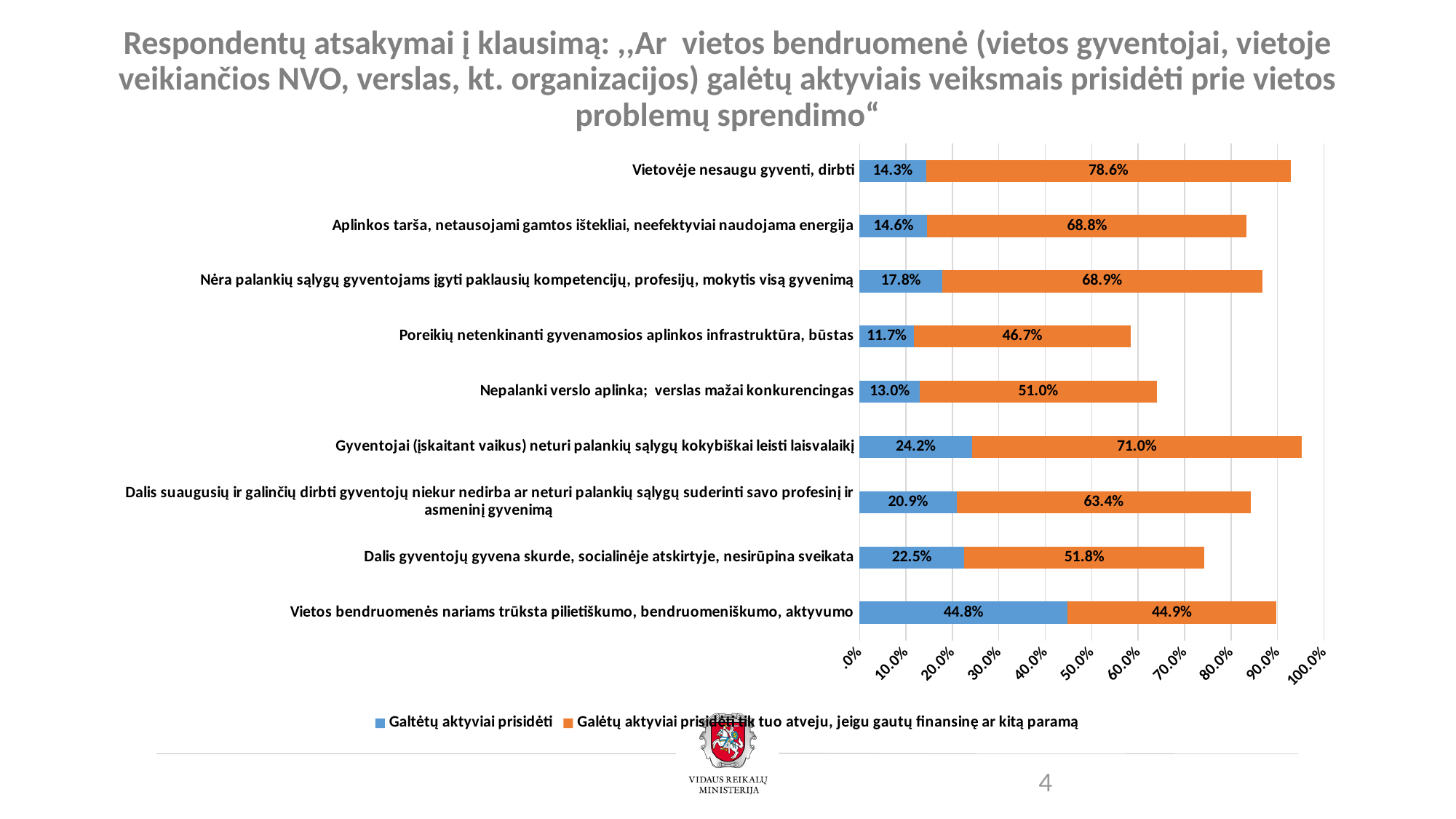
Which is larger for 'Dalis suaugusių ir galinčių dirbti gyventojų niekur nedirba ar neturi palankių sąlygų suderinti savo profesinį ir asmeninį gyvenimą': the 'Galtėtų aktyviai prisidėti' value or the 'Galėtų aktyviai prisidėti tik tuo atveju, jeigu gautų finansinę ar kitą paramą' value? Galėtų aktyviai prisidėti tik tuo atveju, jeigu gautų finansinę ar kitą paramą What is the value of 'Galtėtų aktyviai prisidėti' for 'Vietovėje nesaugu gyventi, dirbti'? 14.3% What is the value of 'Galėtų aktyviai prisidėti tik tuo atveju, jeigu gautų finansinę ar kitą paramą' for 'Nepalanki verslo aplinka; verslas mažai konkurencingas'? 51.0% How many categories (problem statements) are plotted in the chart? 9 What is the total of the stacked bar for 'Gyventojai (įskaitant vaikus) neturi palankių sąlygų kokybiškai leisti laisvalaikį'? 95.2% What is the difference between the two series values for 'Vietovėje nesaugu gyventi, dirbti'? 64.3 percentage points What type of chart is shown on the slide? Stacked bar chart Which category has the highest value for 'Galtėtų aktyviai prisidėti'? Vietos bendruomenės nariams trūksta pilietiškumo, bendruomeniškumo, aktyvumo Which category has the lowest value for 'Galtėtų aktyviai prisidėti'? Poreikių netenkinanti gyvenamosios aplinkos infrastruktūra, būstas What is the value of 'Galtėtų aktyviai prisidėti' for 'Dalis gyventojų gyvena skurde, socialinėje atskirtyje, nesirūpina sveikata'? 22.5% Which category has the highest value for 'Galėtų aktyviai prisidėti tik tuo atveju, jeigu gautų finansinę ar kitą paramą'? Vietovėje nesaugu gyventi, dirbti How many series does the legend list? 2